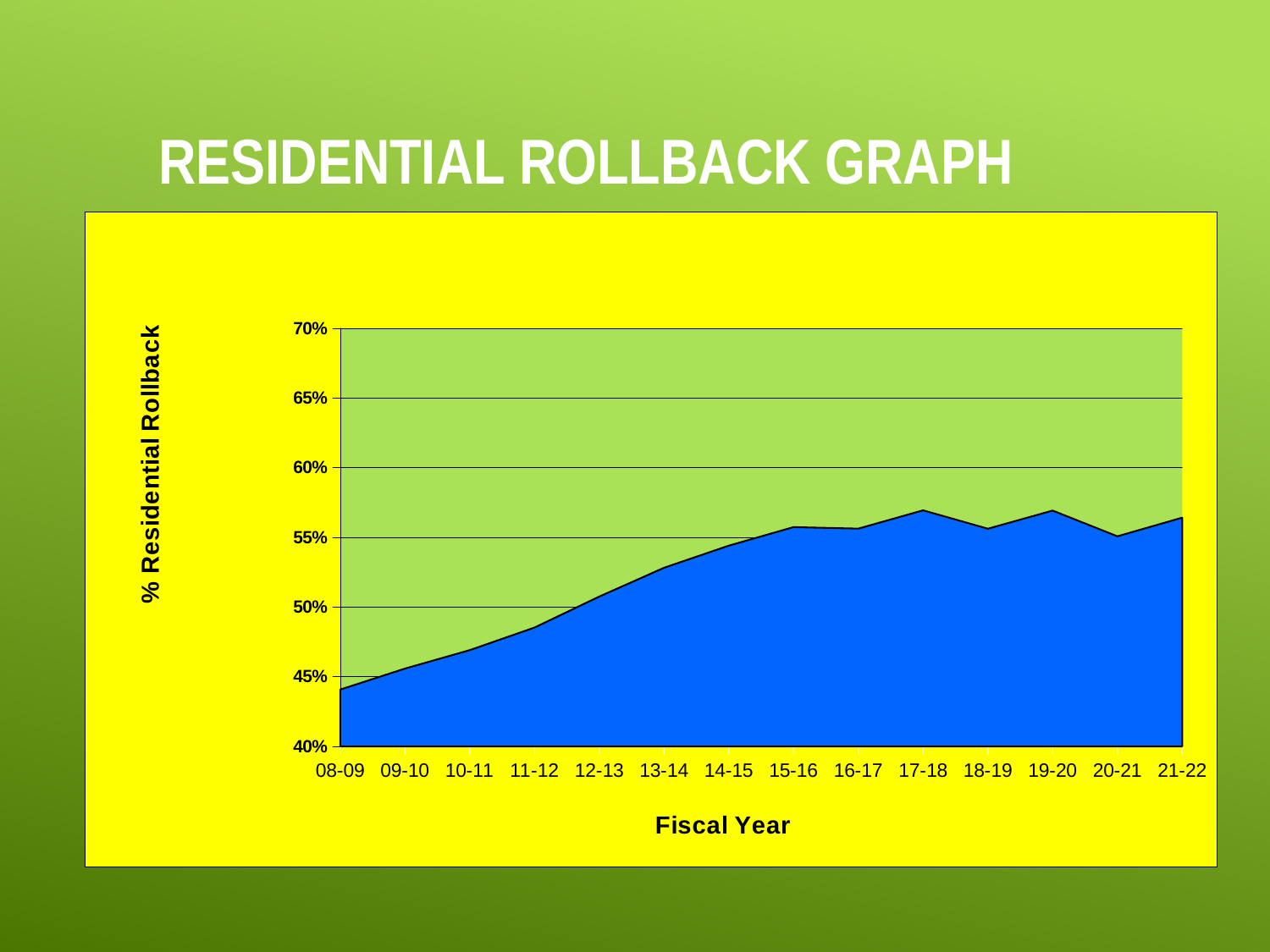
Which has the larger % Residential Rollback, 08-09 or 21-22? 21-22 How many fiscal years are plotted along the x axis? 14 Is the value for 21-22 greater or less than 60%? less Which fiscal year has the lowest % Residential Rollback? 08-09 Does the % Residential Rollback generally rise or fall from 08-09 to 21-22? rise Is the value for 13-14 greater or less than 50%? greater Is the value for 10-11 greater or less than 50%? less What is the title of the chart's x axis? Fiscal Year What kind of chart is shown on the slide? Area chart What is the title of the chart's y axis? % Residential Rollback